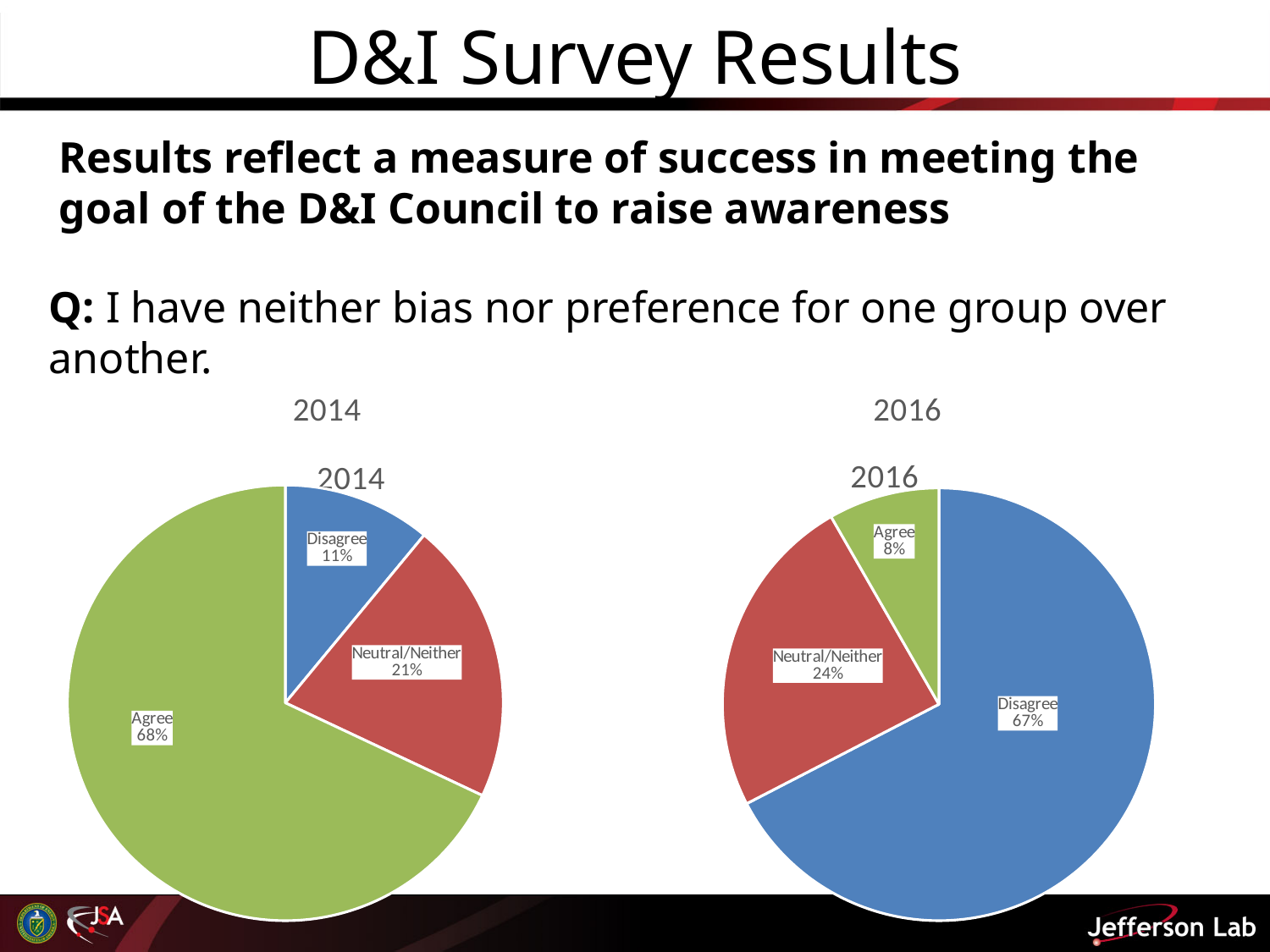
In the 2016 pie chart, what percentage of respondents chose Neutral/Neither? 24% Comparing the two charts, is the Neutral/Neither share larger in 2014 or in 2016? 2016 In the 2014 pie chart, what percentage of respondents chose Disagree? 11% What type of chart is used to show the 2014 results? Pie chart In the 2014 pie chart, what colour is the Agree slice? Green In the 2014 pie chart, what is the difference in percentage points between Agree and Neutral/Neither? 47 In the 2016 pie chart, what is the difference in percentage points between Disagree and Agree? 59 How many slices does the 2016 pie chart have? 3 In the 2016 pie chart, what percentage of respondents chose Disagree? 67% In the 2016 pie chart, which response has the smallest share? Agree In the 2014 pie chart, what percentage of respondents chose Agree? 68% In the 2014 pie chart, which response has the largest share? Agree